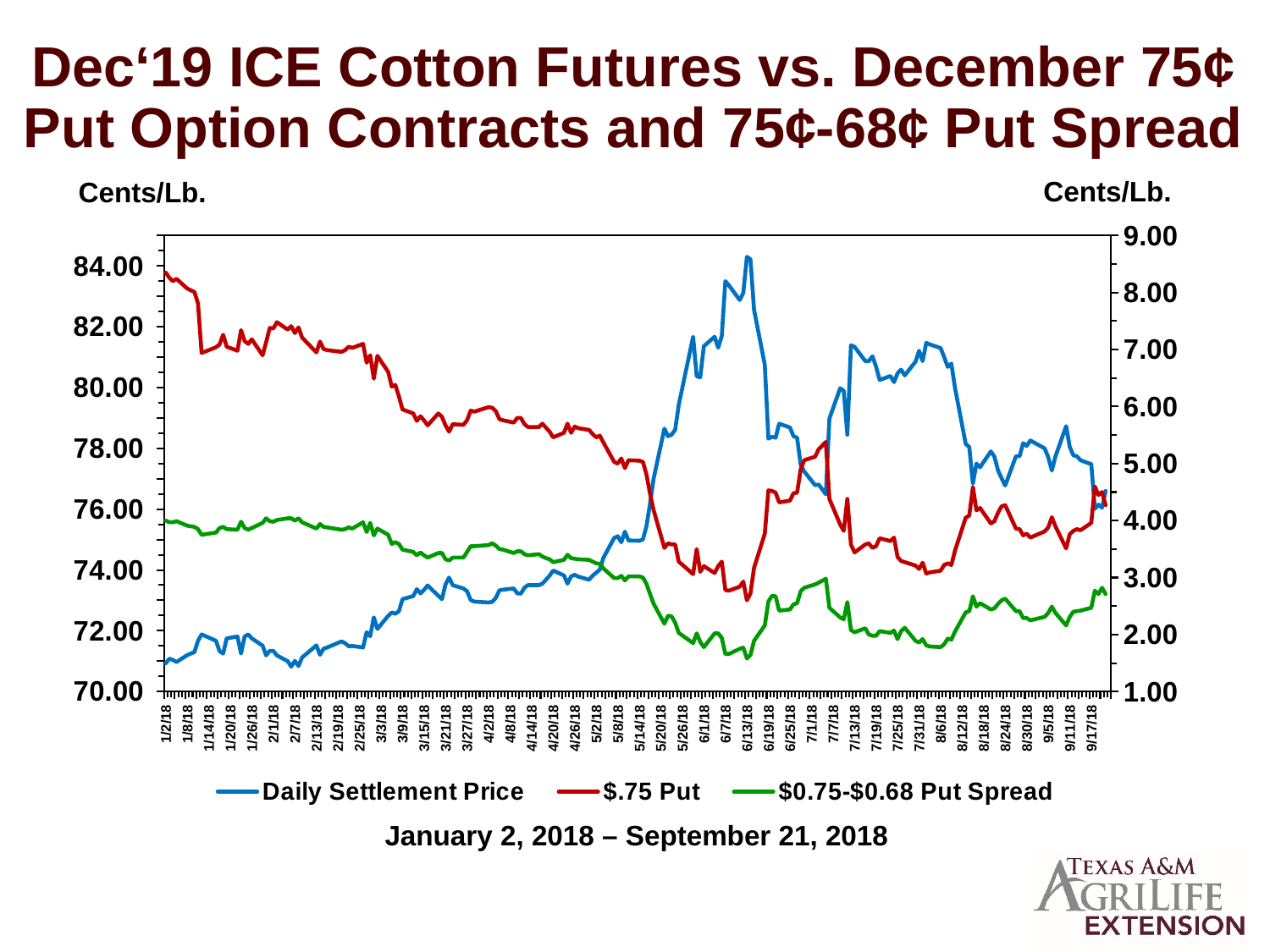
Does the $.75 Put series rise or fall overall from January to September 2018? fall Does the Daily Settlement Price rise or fall overall from January to September 2018? rise Which series is drawn in green? $0.75-$0.68 Put Spread Is the $.75 Put value at the start of the period (1/2/18) greater or less than 8.00? greater In which month does the Daily Settlement Price reach its highest point? June Is the Daily Settlement Price at the start of the period (1/2/18) greater or less than 72.00? less Which is larger: the Daily Settlement Price in mid-June 2018 or in early January 2018? mid-June 2018 Is the peak of the Daily Settlement Price in June 2018 greater or less than 82.00? greater What kind of chart is shown on the slide? line chart Which series is drawn in blue? Daily Settlement Price How many series does the legend list? 3